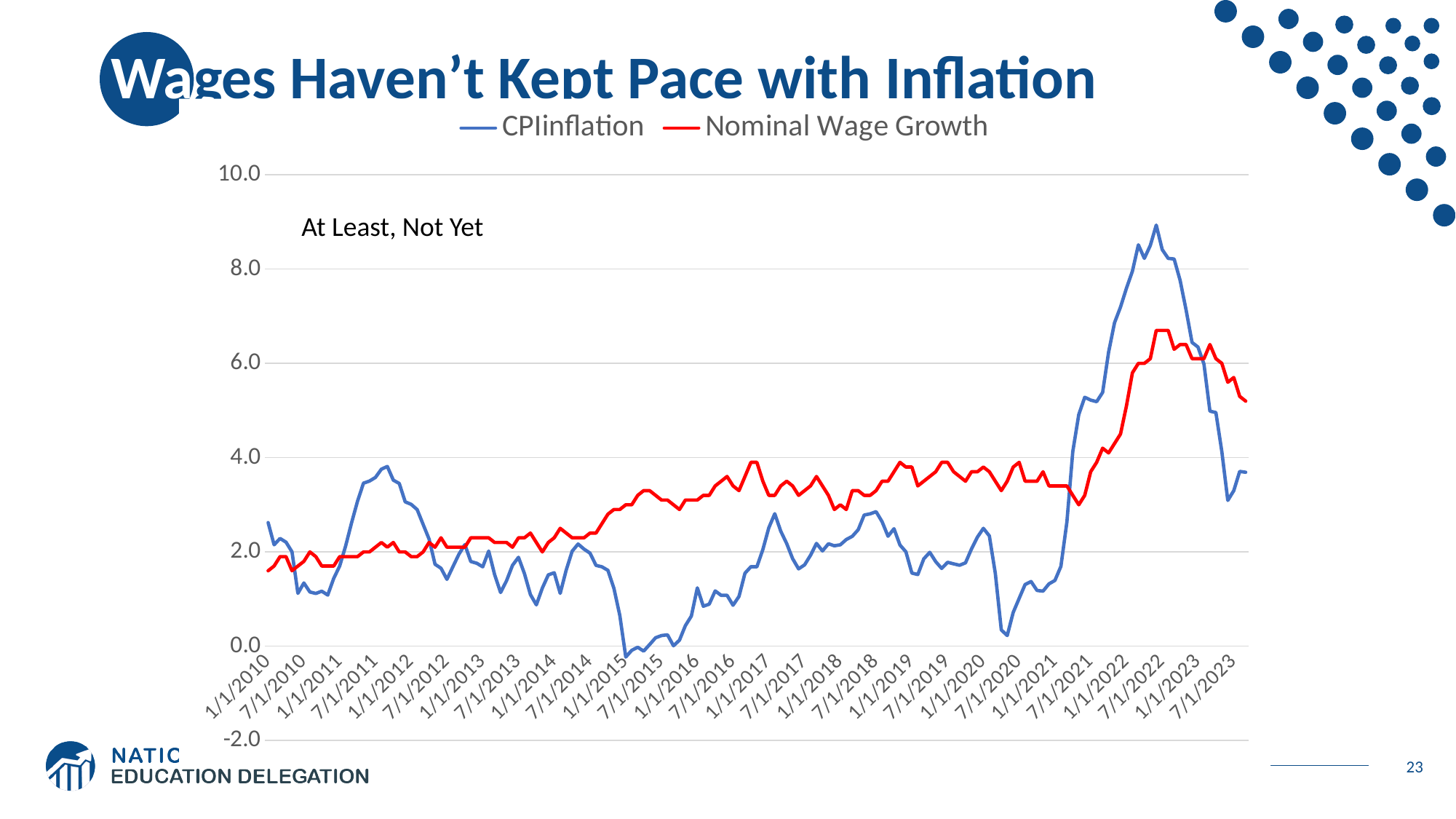
Is the peak value of CPI inflation around 7/1/2022 greater or less than 8.0? greater At 7/1/2022, which series has the higher value, CPI inflation or Nominal Wage Growth? CPI inflation Is the peak value of Nominal Wage Growth around 7/1/2022 greater or less than 6.0? greater Is the value of Nominal Wage Growth at 7/1/2023 greater or less than 4.0? greater Which series is drawn in red? Nominal Wage Growth At 1/1/2017, which series has the higher value, CPI inflation or Nominal Wage Growth? Nominal Wage Growth What is the title of the chart? Wages Haven't Kept Pace with Inflation Which series reaches the highest value anywhere on the chart? CPI inflation What kind of chart is shown on the slide? line chart Does Nominal Wage Growth rise or fall between 7/1/2022 and 7/1/2023? fall How many series does the legend list? 2